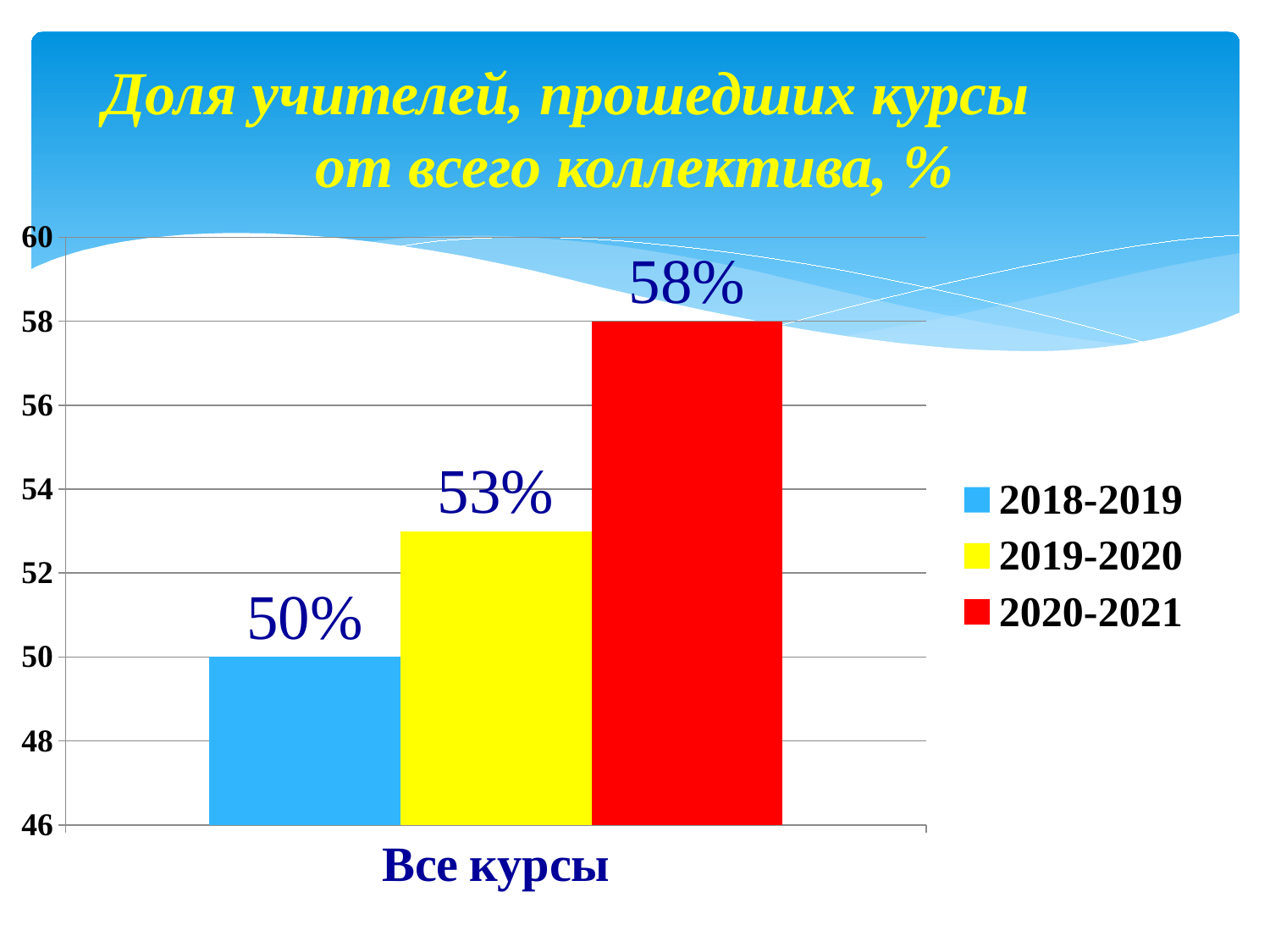
What is the difference between the values for 2019-2020 and 2018-2019? 3% What is the difference between the values for 2020-2021 and 2018-2019? 8% Which series has the lowest value? 2018-2019 Which is larger, the value for 2019-2020 or the value for 2020-2021? 2020-2021 Is the value for 2019-2020 greater or less than 52? greater What is the value for 2020-2021? 58% What is the value for 2018-2019? 50% What kind of chart is shown on the slide? bar chart What is the value for 2019-2020? 53% Which series has the highest value? 2020-2021 What colour is the bar for 2020-2021? red How many series does the legend list? 3